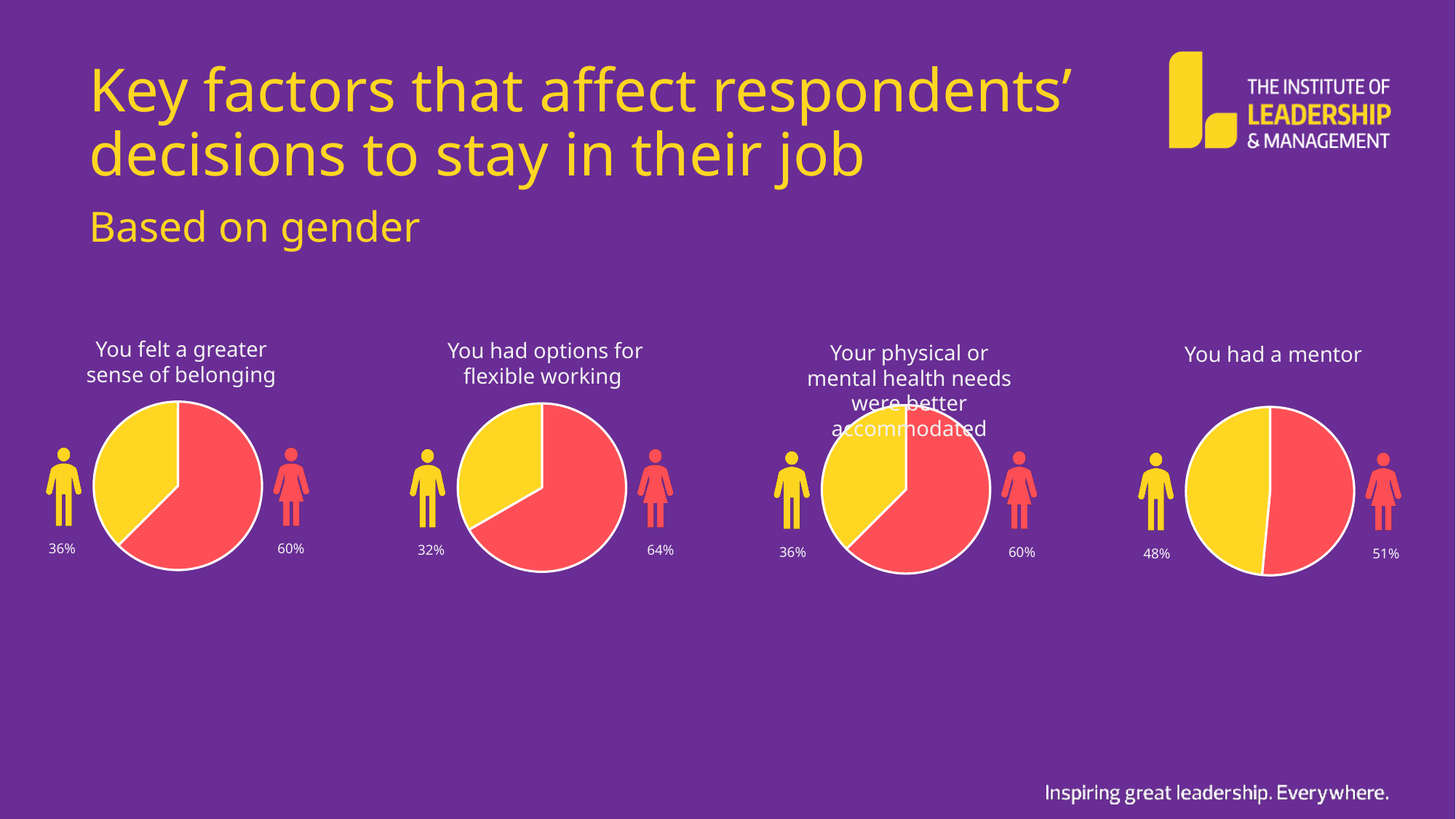
In the 'You felt a greater sense of belonging' chart, what percentage is shown next to the female figure? 60% In the 'Your physical or mental health needs were better accommodated' chart, what percentage is shown next to the male figure? 36% How many pie charts are shown on the slide? 4 In the 'You had options for flexible working' chart, what is the difference between the female and male percentages? 32% Across the four pie charts, which factor shows the highest female percentage? You had options for flexible working In the 'You felt a greater sense of belonging' chart, which figure has the larger percentage, male or female? Female What type of chart is used for 'You had a mentor'? Pie chart In the 'You had a mentor' chart, what percentage is shown next to the male figure? 48% In the 'You felt a greater sense of belonging' chart, what percentage is shown next to the male figure? 36% In the 'You had options for flexible working' chart, what percentage is shown next to the male figure? 32% In the 'You had options for flexible working' chart, what percentage is shown next to the female figure? 64% In the 'You had a mentor' chart, what percentage is shown next to the female figure? 51%